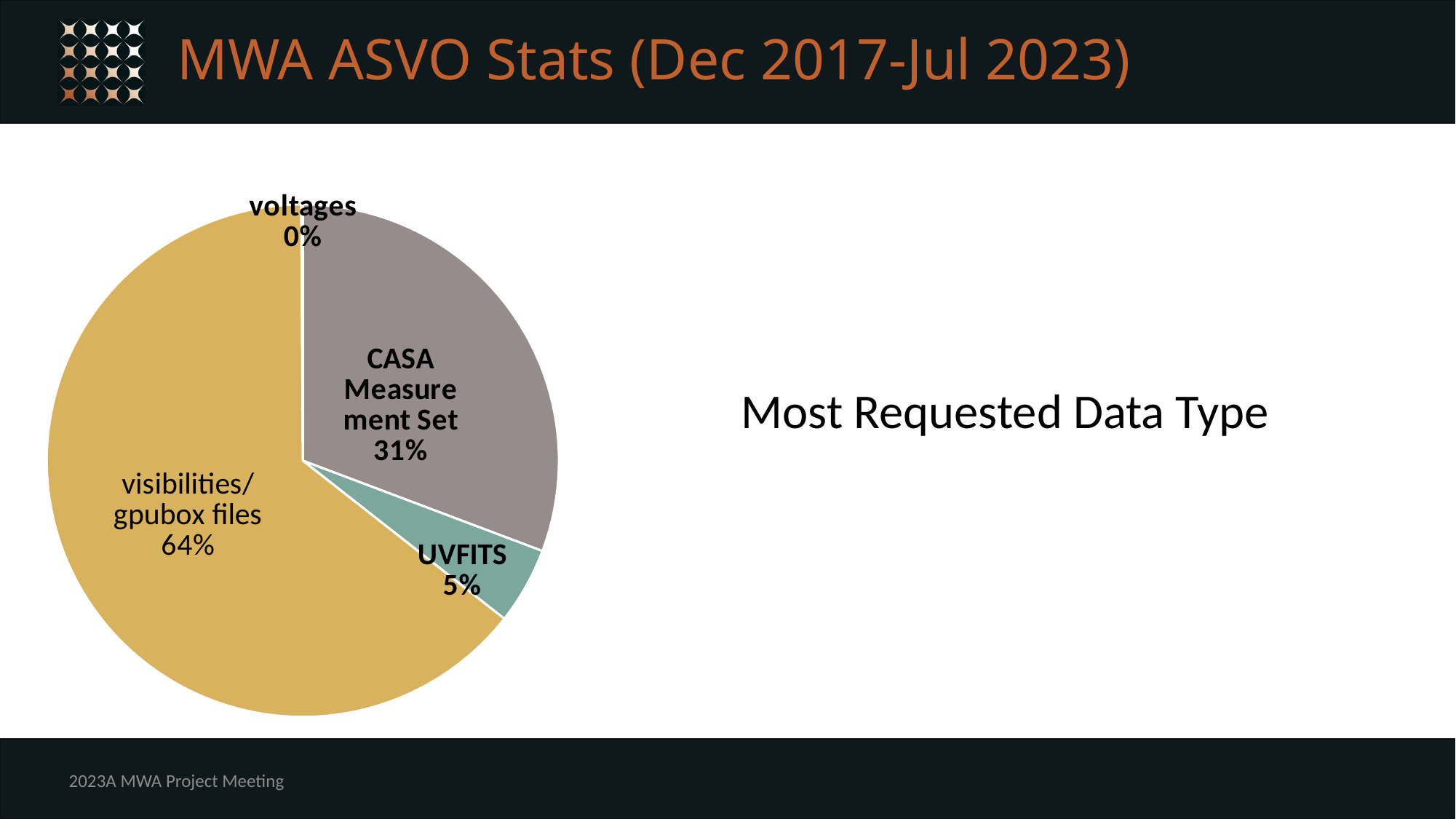
What is the difference in percentage points between visibilities/gpubox files and CASA Measurement Set? 33 Which is larger, the share for CASA Measurement Set or the share for UVFITS? CASA Measurement Set How many slices (categories) does the pie chart have? 4 What is the combined share of CASA Measurement Set and UVFITS? 36% What share of the pie is labelled for CASA Measurement Set? 31% Which data type has the smallest slice of the pie? voltages What share of the pie is labelled for voltages? 0% What share of the pie is labelled for UVFITS? 5% What colour is the slice for visibilities/gpubox files? yellow What kind of chart is shown on the slide? pie chart Which data type has the largest slice of the pie? visibilities/gpubox files